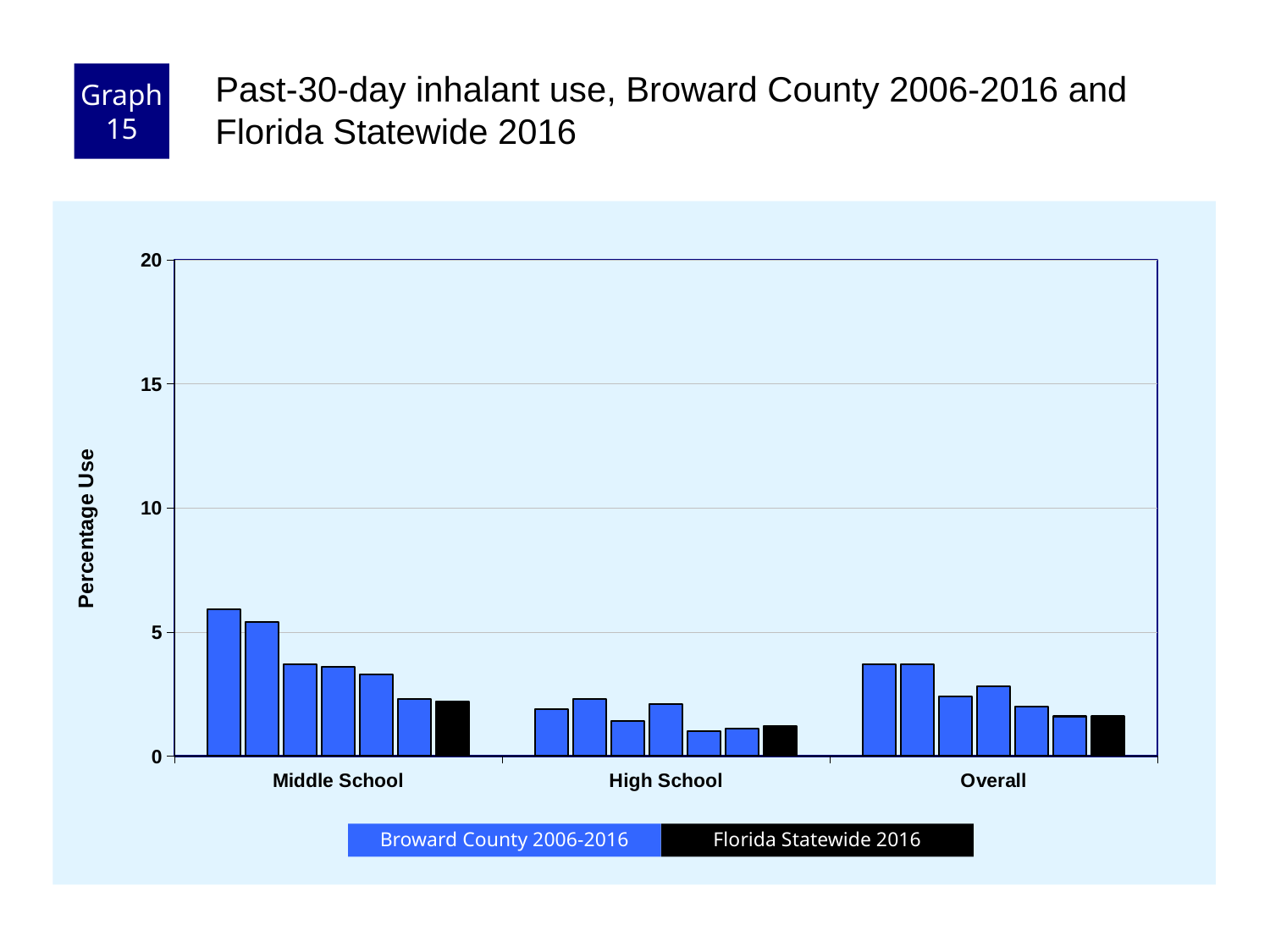
Which category group contains the tallest bar on the chart? Middle School Do the Broward County bars in the Middle School group generally rise or fall from left to right? fall How many bars are plotted in the Middle School group? 7 Which is larger, the Florida Statewide 2016 bar for Middle School or the Florida Statewide 2016 bar for High School? Middle School What is the label on the y axis? Percentage Use How many school-level categories are shown on the x axis? 3 Is the Florida Statewide 2016 bar for Overall greater or less than 5? less How many series does the legend list? 2 Is the tallest Broward County bar in the Middle School group greater or less than 5? greater Is the Florida Statewide 2016 bar for High School greater or less than 5? less What kind of chart is shown on the slide? bar chart Which category group has the lowest bars overall? High School